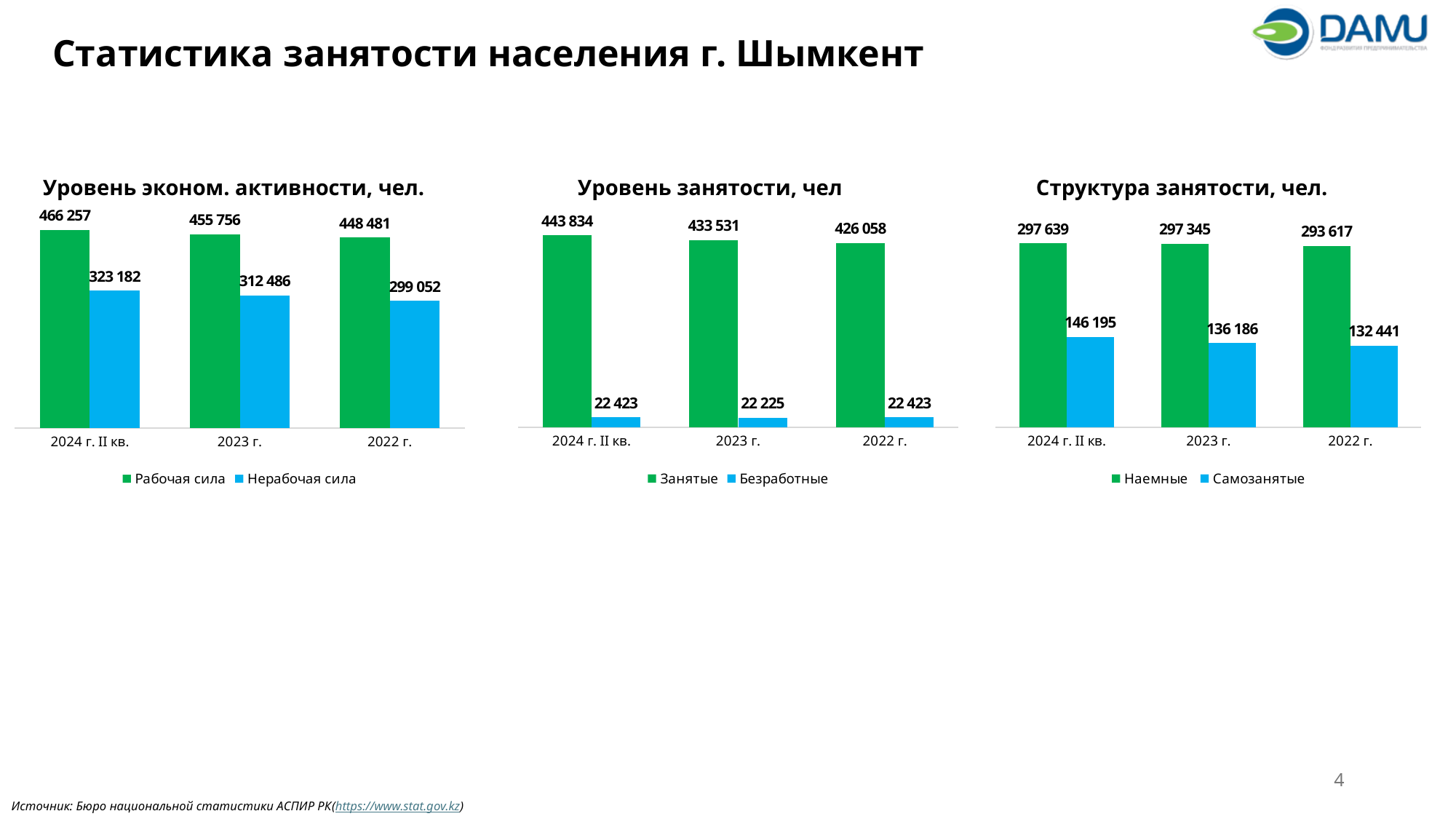
In the chart 'Уровень занятости, чел', which period has the highest value of Занятые? 2024 г. II кв. In the chart 'Структура занятости, чел.', what is the value of Самозанятые for 2024 г. II кв.? 146 195 In the chart 'Уровень эконом. активности, чел.', what is the difference between Рабочая сила and Нерабочая сила for 2024 г. II кв.? 143 075 What type of chart is 'Уровень эконом. активности, чел.'? Bar chart In the chart 'Уровень занятости, чел', what is the difference between Занятые for 2024 г. II кв. and Занятые for 2022 г.? 17 776 In the chart 'Уровень эконом. активности, чел.', what is the value of Рабочая сила for 2024 г. II кв.? 466 257 In the chart 'Уровень эконом. активности, чел.', what is the value of Нерабочая сила for 2022 г.? 299 052 In the chart 'Уровень занятости, чел', what is the value of Занятые for 2023 г.? 433 531 In the chart 'Структура занятости, чел.', how many series does the legend list? 2 In the chart 'Структура занятости, чел.', which period has the lowest value of Самозанятые? 2022 г. In the chart 'Уровень занятости, чел', what is the value of Безработные for 2023 г.? 22 225 In the chart 'Структура занятости, чел.', what is the difference between Самозанятые for 2024 г. II кв. and Самозанятые for 2022 г.? 13 754